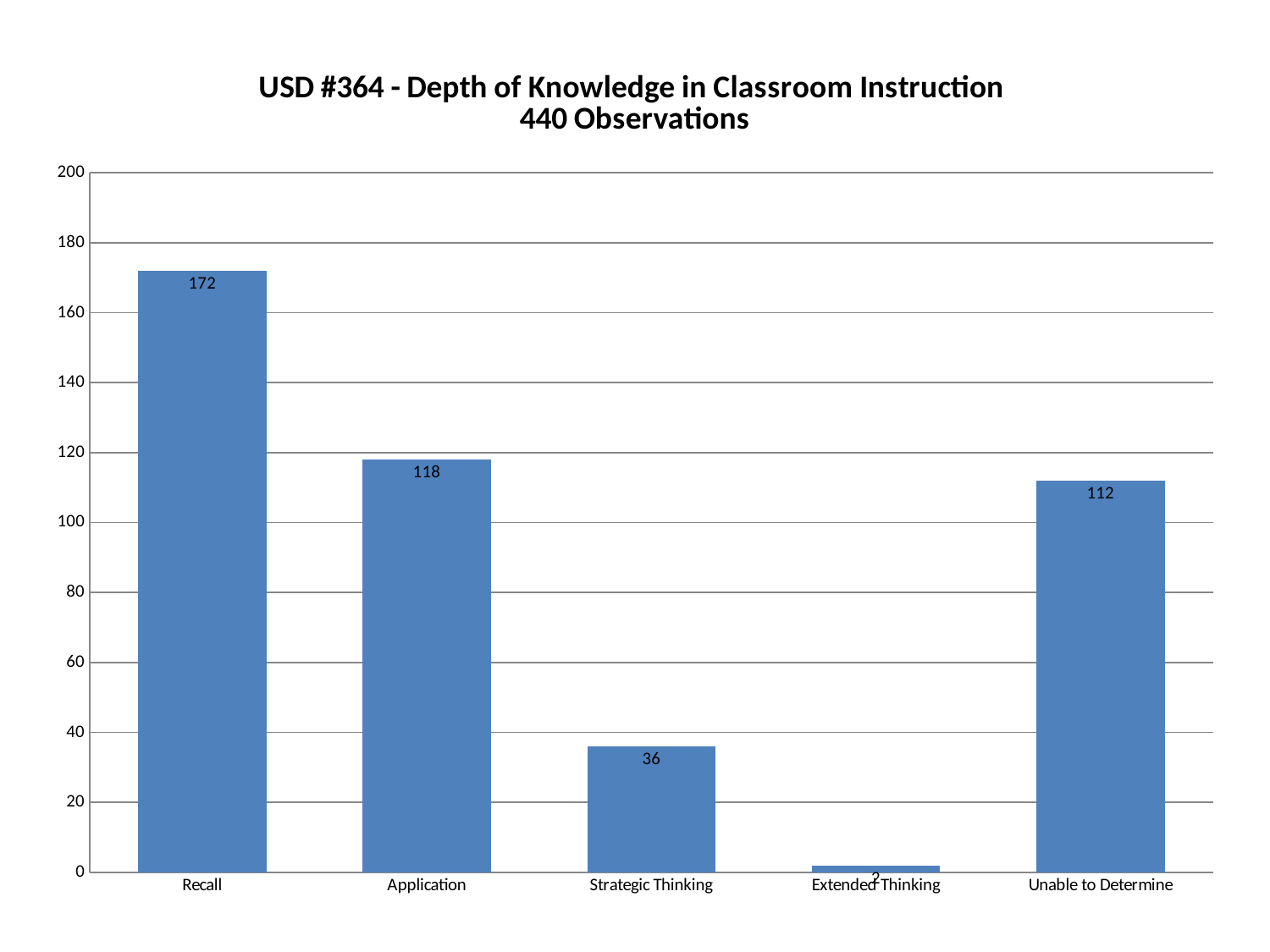
What is the title of the chart? USD #364 - Depth of Knowledge in Classroom Instruction 440 Observations What is the value for Recall? 172 What is the value for Unable to Determine? 112 What is the value for Strategic Thinking? 36 Is the value for Strategic Thinking greater or less than 40? less What is the difference between the values for Recall and Application? 54 How many categories are shown on the x axis? 5 Which category has the lowest value? Extended Thinking What is the value for Application? 118 Which is larger, the value for Application or the value for Unable to Determine? Application Which category has the highest value? Recall What kind of chart is this? bar chart